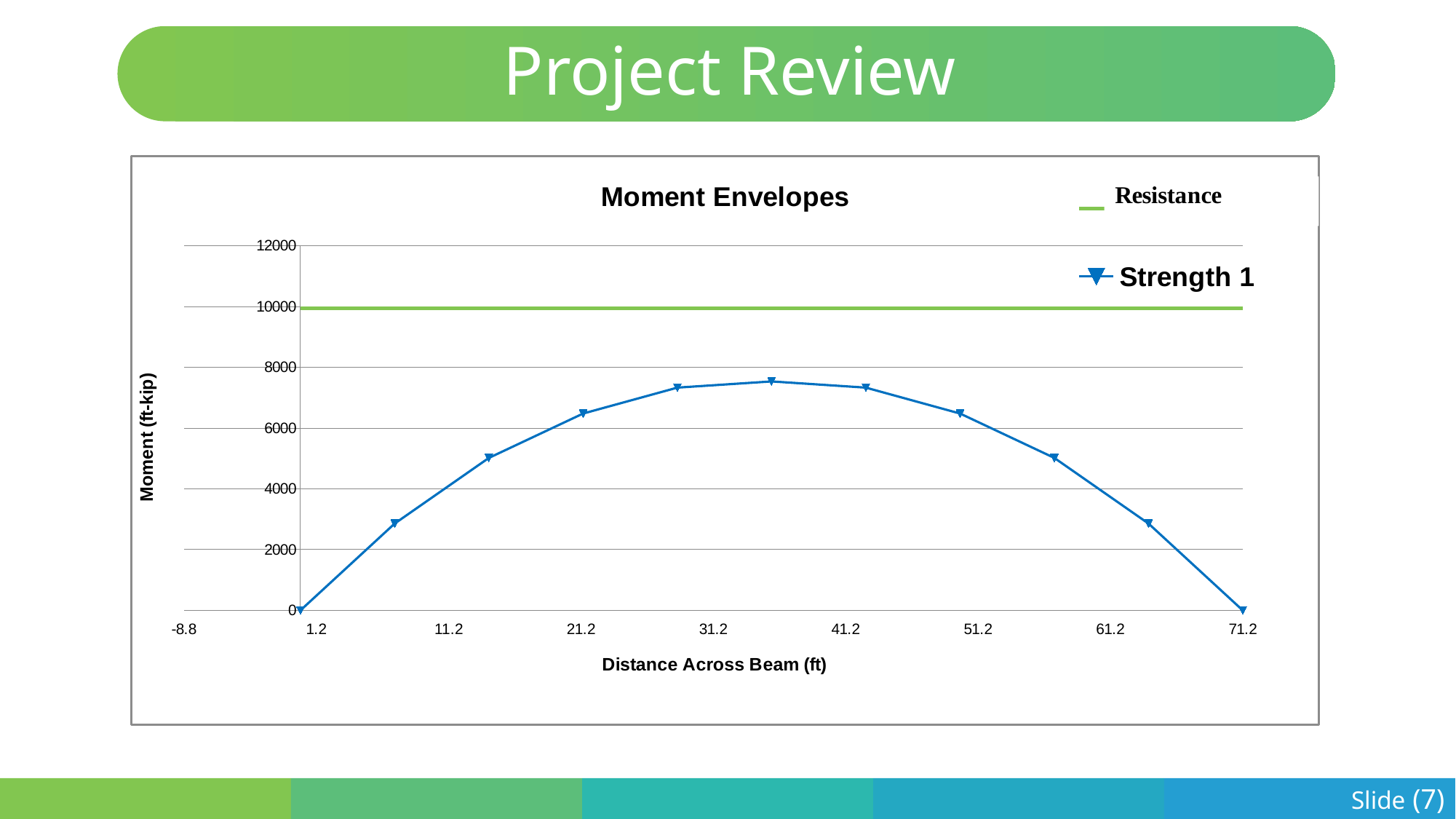
What kind of chart is shown on the slide? line chart How many data points are plotted for the Strength 1 series? 11 Is the value of the Resistance line greater or less than 8000? greater How many series does the legend of the Moment Envelopes chart list? 2 Does the Strength 1 series rise or fall between 41.2 ft and 71.2 ft along the x axis? fall What is the title of the chart? Moment Envelopes Is the Strength 1 value at 71.2 ft greater or less than 2000? less Which series reaches the higher moment values on the chart? Resistance Which series has the larger value at a distance of 31.2 ft, Resistance or Strength 1? Resistance What is the label on the vertical axis of the chart? Moment (ft-kip) Does the Strength 1 series rise or fall between 1.2 ft and 31.2 ft along the x axis? rise Is the highest value of the Strength 1 series greater or less than 8000? less